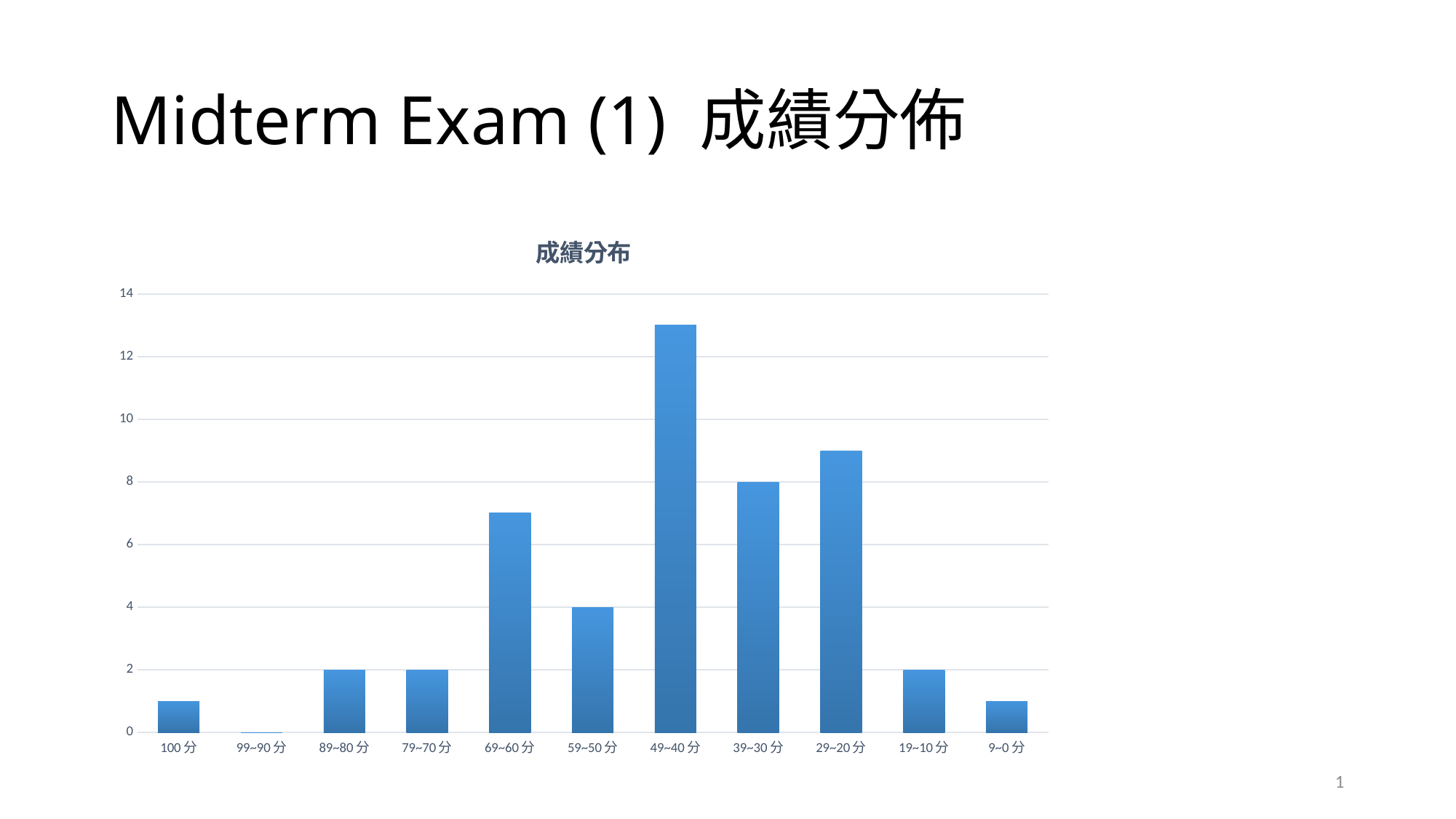
Which score category has the highest bar? 49~40 分 Which score category has the lowest bar? 99~90 分 What is the value for 59~50 分? 4 What kind of chart is shown on the slide? bar chart What is the title of the chart? 成績分布 Which is larger, the value for 39~30 分 or the value for 59~50 分? 39~30 分 What is the value for 89~80 分? 2 Is the value for 49~40 分 greater or less than 12? greater What is the value for 39~30 分? 8 Is the value for 69~60 分 greater or less than 6? greater How many score categories are shown on the x axis? 11 What is the difference between the values for 39~30 分 and 59~50 分? 4